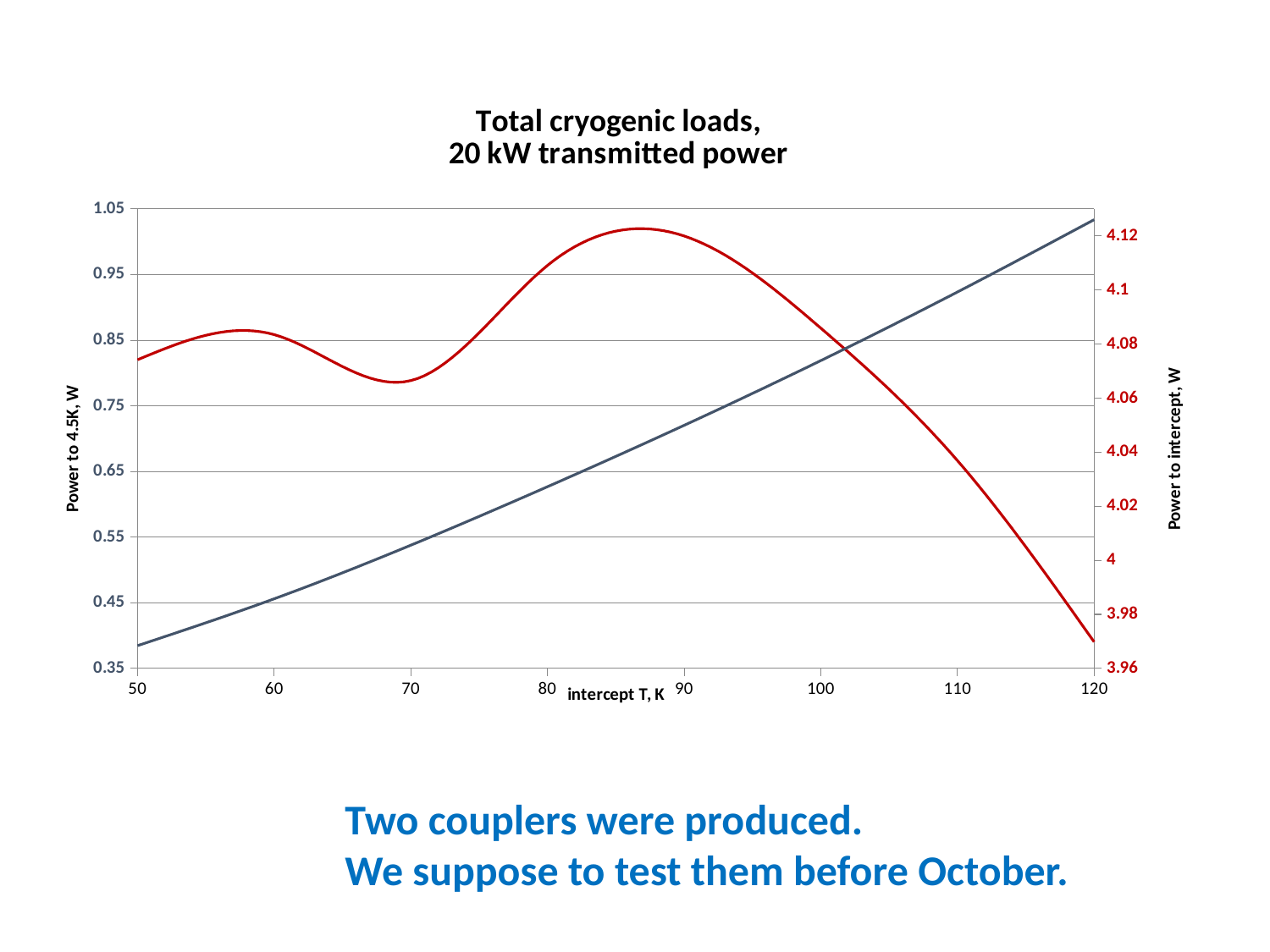
What is the label of the right-hand vertical axis? Power to intercept, W Is the red line (Power to intercept) higher at intercept T = 50 or at intercept T = 120? 50 Is the value of the dark blue line (Power to 4.5K) at intercept T = 50 greater or less than 0.45? less What is the title of the chart? Total cryogenic loads, 20 kW transmitted power Is the value of the dark blue line (Power to 4.5K) at intercept T = 100 greater or less than 0.75? greater How many lines are plotted on the chart? 2 Is the value of the red line (Power to intercept) at intercept T = 120 greater or less than 4? less What kind of chart is shown on the slide? line chart Does the dark blue line (Power to 4.5K) rise or fall as intercept T increases from 50 to 120? rise How many tick labels are shown on the x axis (intercept T, K)? 8